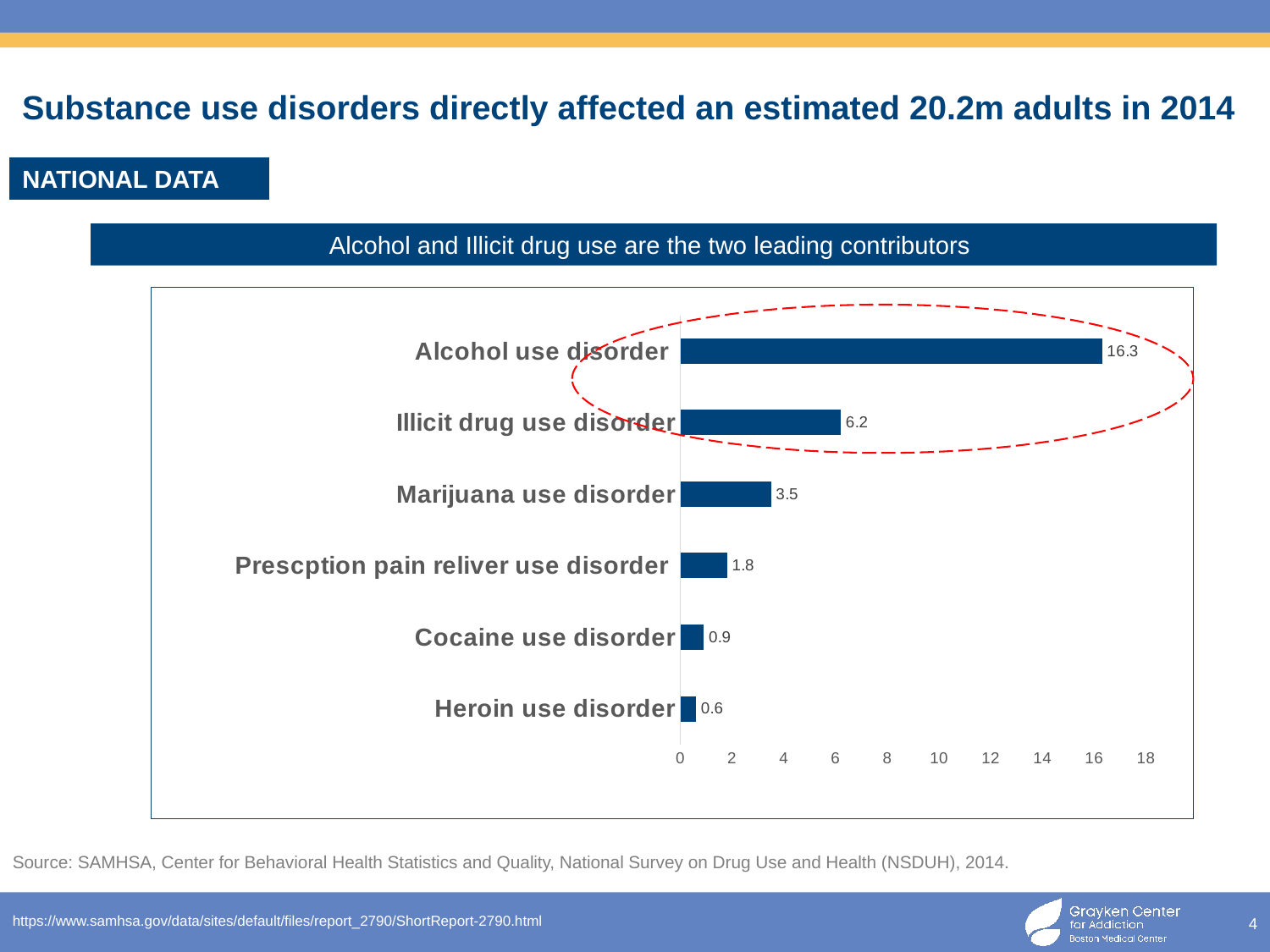
What is the value for Marijuana use disorder? 3.5 What is the value for Alcohol use disorder? 16.3 What kind of chart is shown on the slide? Bar chart Which two categories are circled with a red dashed outline on the chart? Alcohol use disorder and Illicit drug use disorder How many categories are shown in the chart? 6 Which category has the highest value? Alcohol use disorder What is the difference between the values for Alcohol use disorder and Illicit drug use disorder? 10.1 What is the difference between the values for Cocaine use disorder and Heroin use disorder? 0.3 Which category has the lowest value? Heroin use disorder What is the value for Heroin use disorder? 0.6 Which is larger, the value for Marijuana use disorder or the value for Prescption pain reliver use disorder? Marijuana use disorder What is the value for Illicit drug use disorder? 6.2